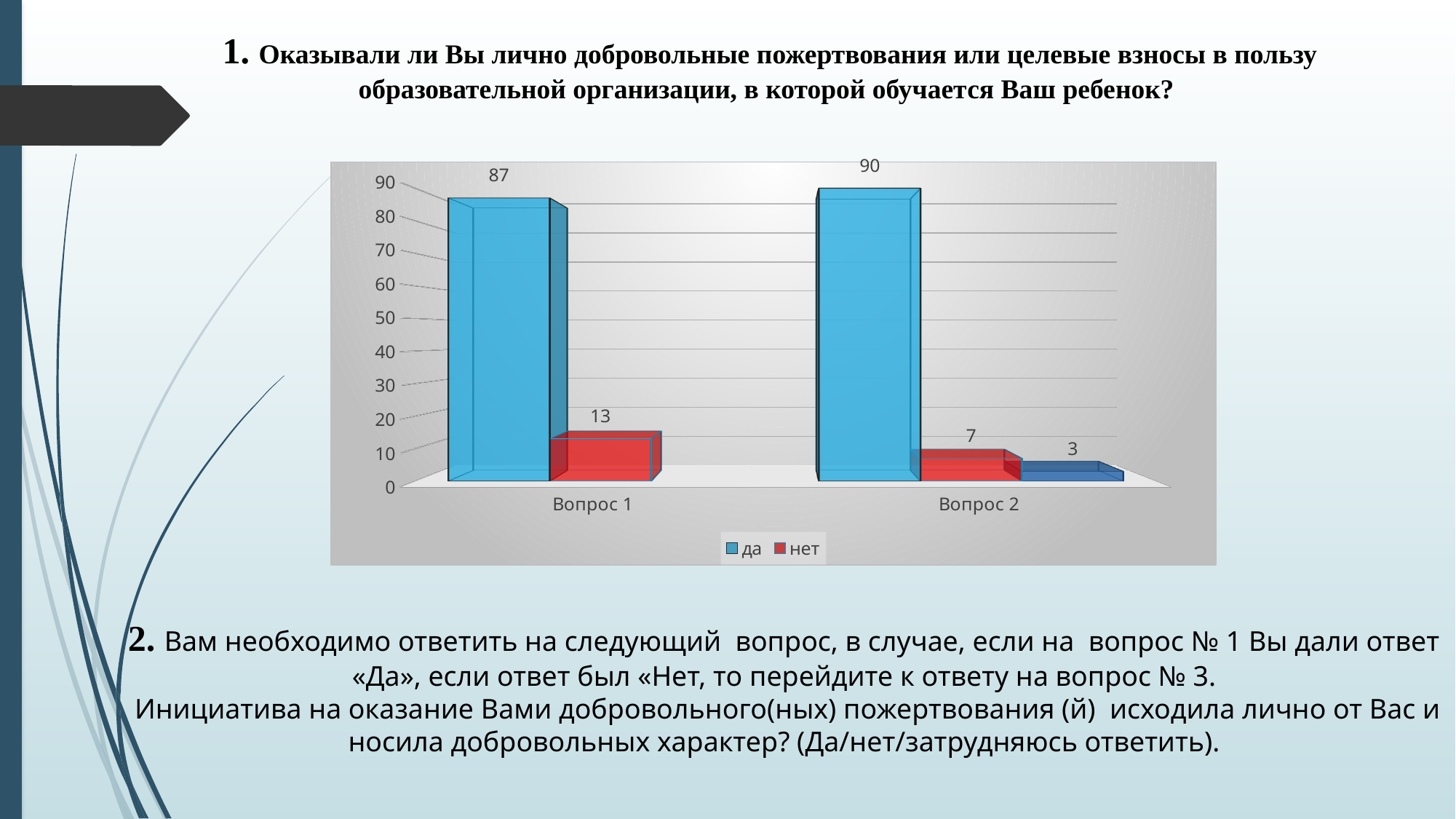
Which category has the lowest "нет" value? Вопрос 2 What colour are the "да" bars? Blue What kind of chart is shown on the slide? Bar chart What is the value of "да" for Вопрос 1? 87 How many series does the legend list? 2 Which category has the higher value for "да", Вопрос 1 or Вопрос 2? Вопрос 2 What is the value of "нет" for Вопрос 1? 13 What is the value of "да" for Вопрос 2? 90 What is the difference between the "да" and "нет" values for Вопрос 1? 74 What is the value of "нет" for Вопрос 2? 7 What is the difference between the "нет" values for Вопрос 1 and Вопрос 2? 6 How many categories are shown on the x axis? 2